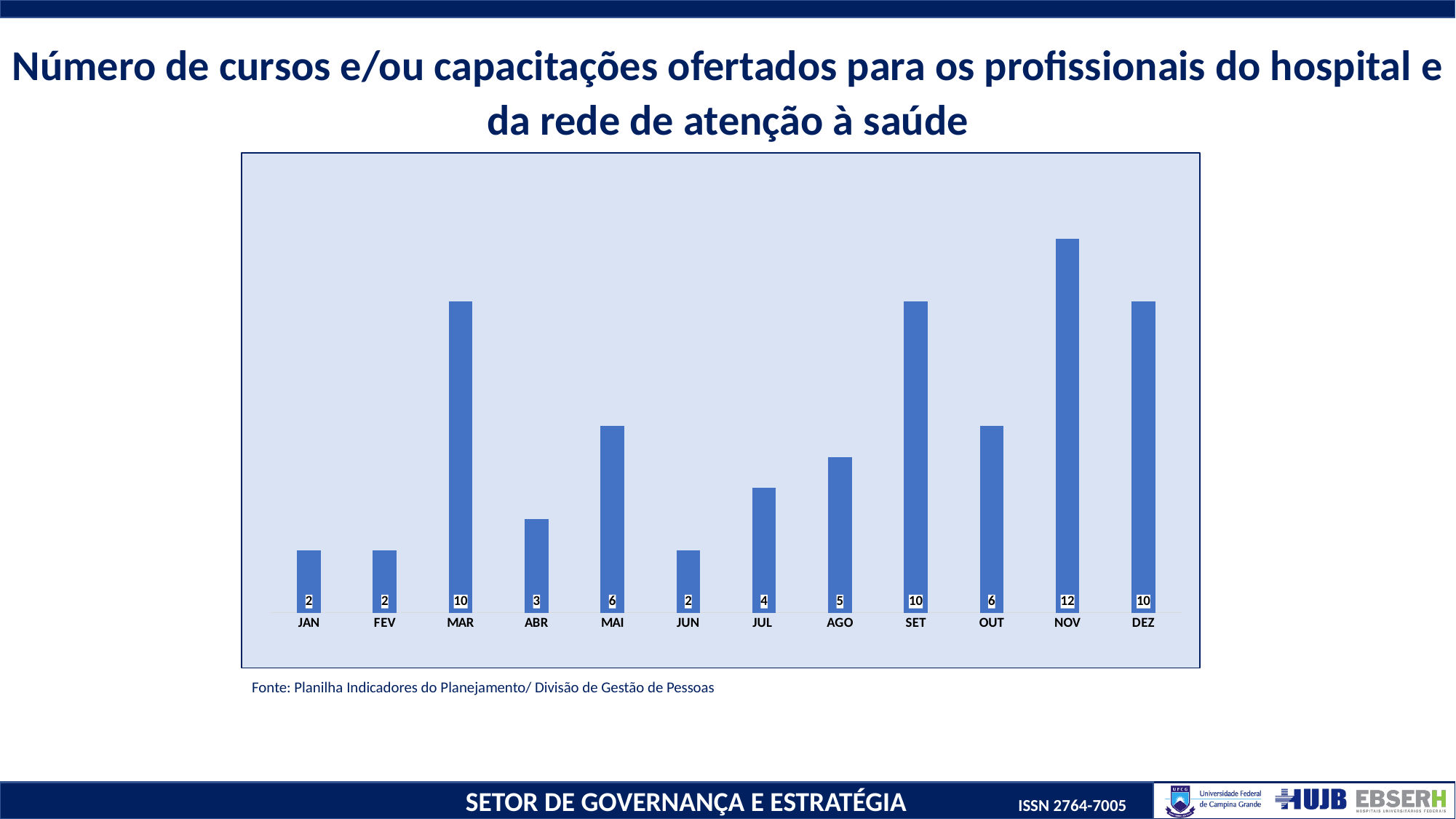
What is the difference between the values for NOV and OUT? 6 Which month has the highest value? NOV How many months are shown on the x axis? 12 What is the value for AGO? 5 Do the values rise or fall from JUN to NOV? rise What kind of chart is shown on the slide? bar chart What is the value for MAR? 10 What source is cited below the chart? Planilha Indicadores do Planejamento/ Divisão de Gestão de Pessoas What is the value for ABR? 3 Which is larger, the value for MAI or the value for JUL? MAI What is the difference between the values for SET and DEZ? 0 What is the value for NOV? 12